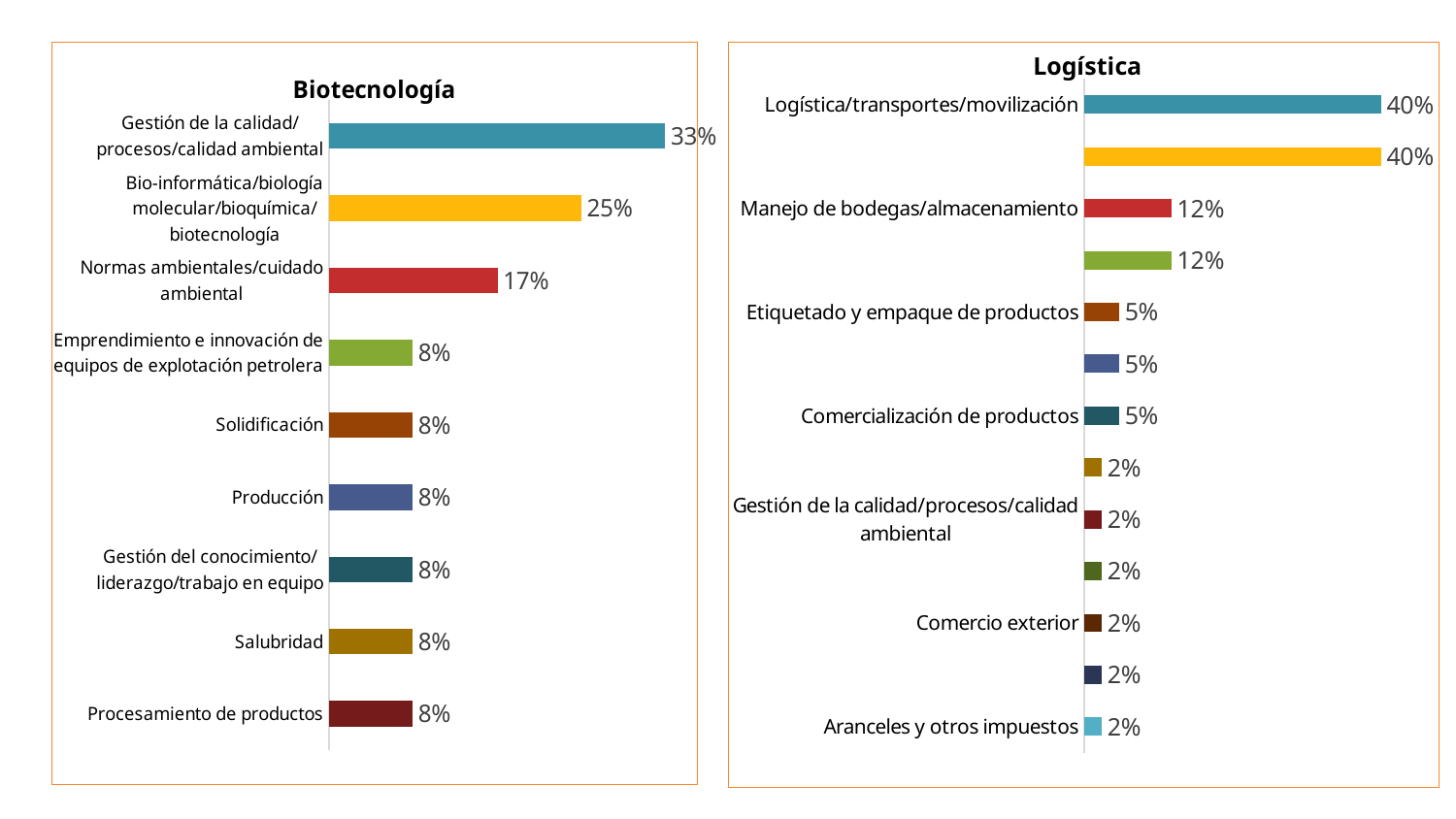
In the Biotecnología chart, what is the value for Bio-informática/biología molecular/bioquímica/biotecnología? 25% In the Logística chart, what is the value for Logística/transportes/movilización? 40% In the Logística chart, what is the value for Comercio exterior? 2% In the Logística chart, what is the value for Manejo de bodegas/almacenamiento? 12% How many bars are plotted in the Logística chart? 13 How many bars are plotted in the Biotecnología chart? 9 In the Biotecnología chart, what is the value for Normas ambientales/cuidado ambiental? 17% In the Logística chart, what is the difference between Logística/transportes/movilización and Etiquetado y empaque de productos? 35% In the Biotecnología chart, what is the difference between Gestión de la calidad/procesos/calidad ambiental and Salubridad? 25% What type of chart is the Logística chart? Bar chart In the Biotecnología chart, which is larger: Normas ambientales/cuidado ambiental or Producción? Normas ambientales/cuidado ambiental In the Biotecnología chart, which category has the highest value? Gestión de la calidad/procesos/calidad ambiental